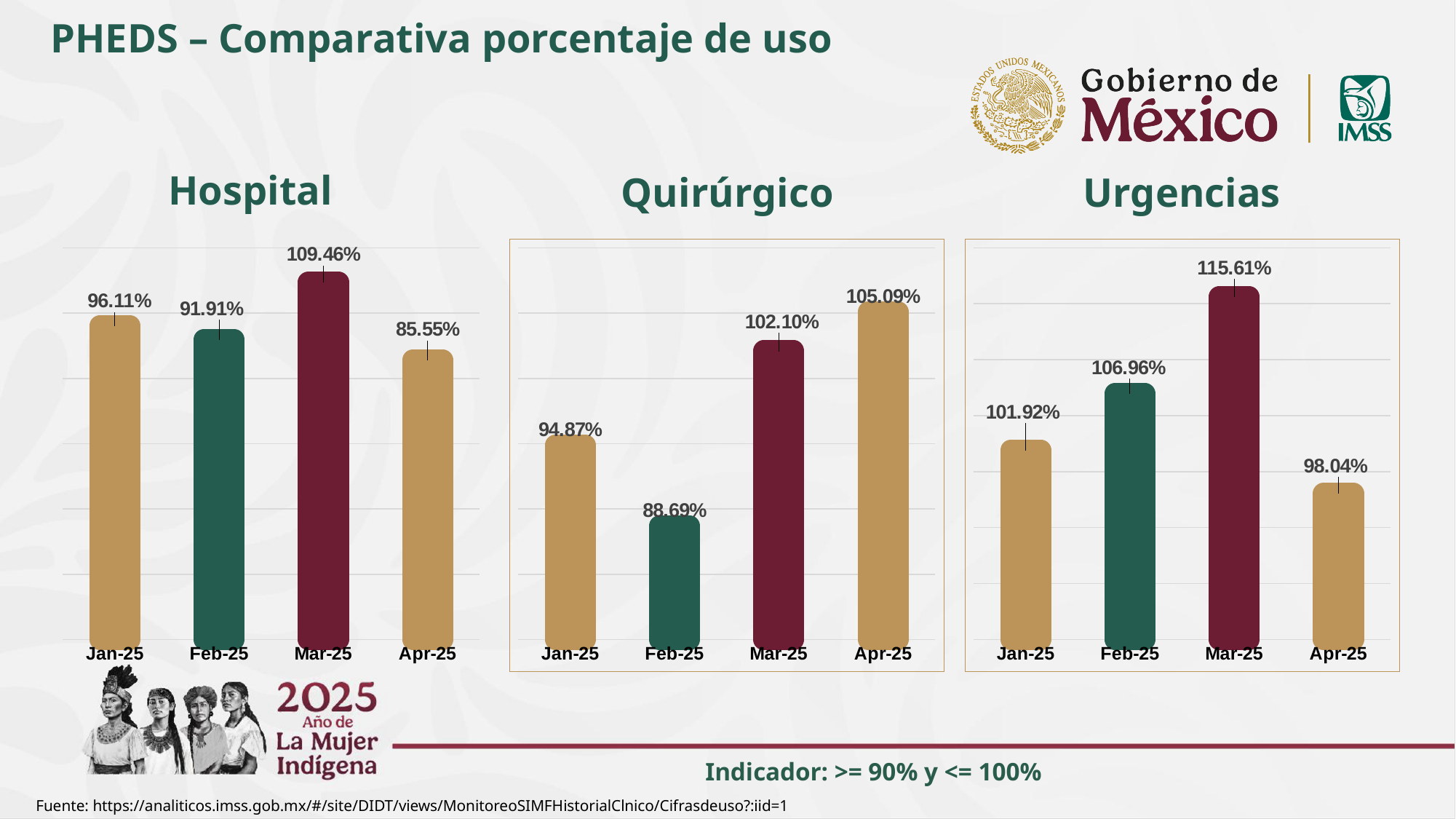
In the Urgencias chart, what is the difference between the Mar-25 and Apr-25 values? 17.57% In the Quirúrgico chart, what is the value for Feb-25? 88.69% In the Hospital chart, which month has the lowest value? Apr-25 In the Quirúrgico chart, what is the difference between the Apr-25 and Jan-25 values? 10.22% In the Hospital chart, what is the value for Mar-25? 109.46% In the Urgencias chart, what is the value for Apr-25? 98.04% In the Quirúrgico chart, do the values rise or fall from Feb-25 to Apr-25? Rise In the Hospital chart, which is larger, the value for Jan-25 or Feb-25? Jan-25 In the Quirúrgico chart, which month has the highest value? Apr-25 What kind of chart is the Hospital chart? Bar chart How many months are shown in the Urgencias chart? 4 In the Urgencias chart, which month has the highest value? Mar-25